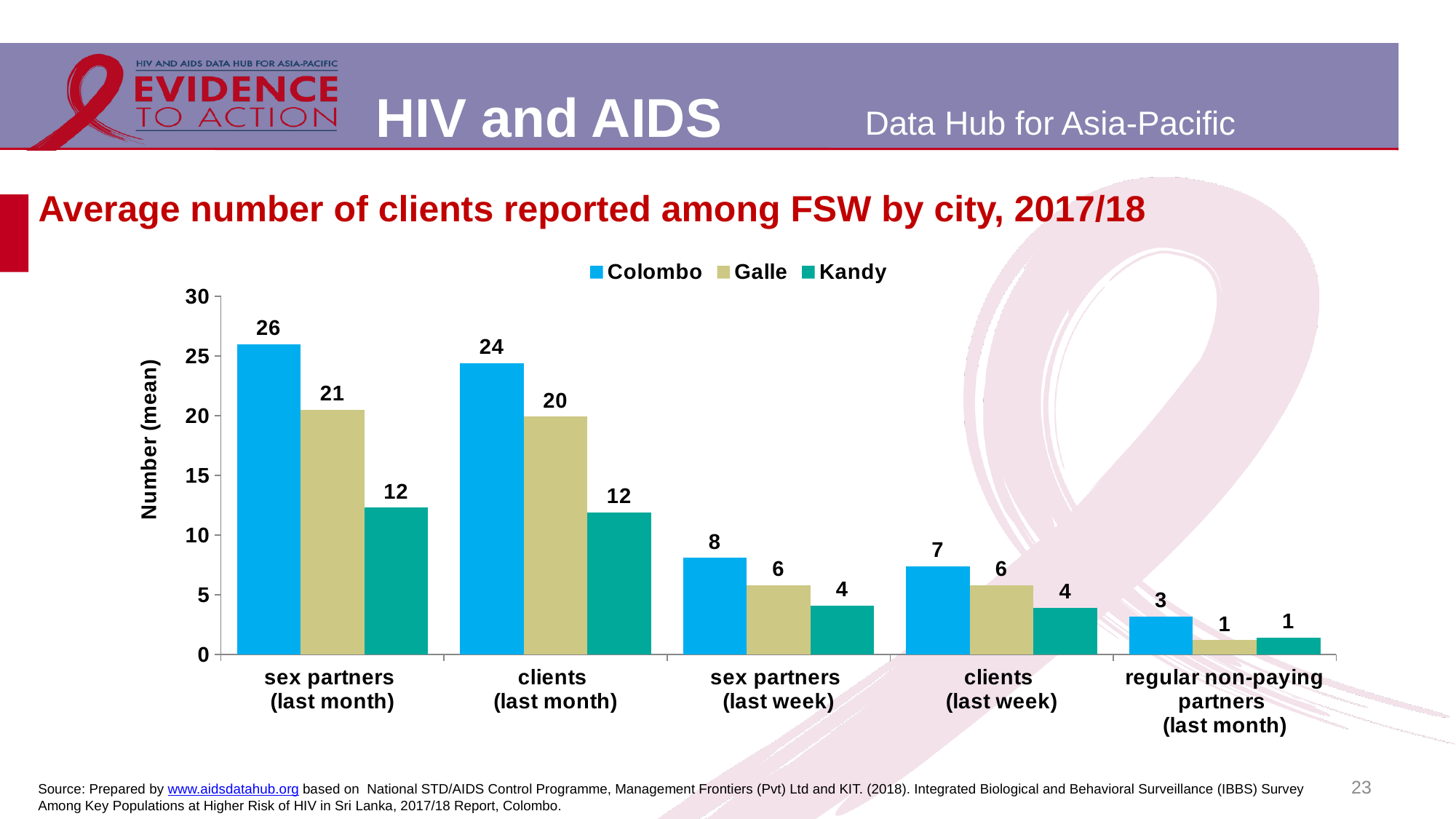
Which city has the lowest value for clients (last month)? Kandy What is the value for Colombo for regular non-paying partners (last month)? 3 What is the value for Galle for clients (last month)? 20 What is the value for Colombo for sex partners (last month)? 26 How many series does the legend list? 3 What is the label of the y axis? Number (mean) Which city has the highest value for clients (last week)? Colombo What is the difference between the Colombo and Kandy values for sex partners (last month)? 14 What is the value for Kandy for sex partners (last week)? 4 How many categories are shown on the x axis? 5 Which is larger: the Galle value for sex partners (last week) or the Kandy value for sex partners (last week)? Galle What kind of chart is shown on the slide? Bar chart